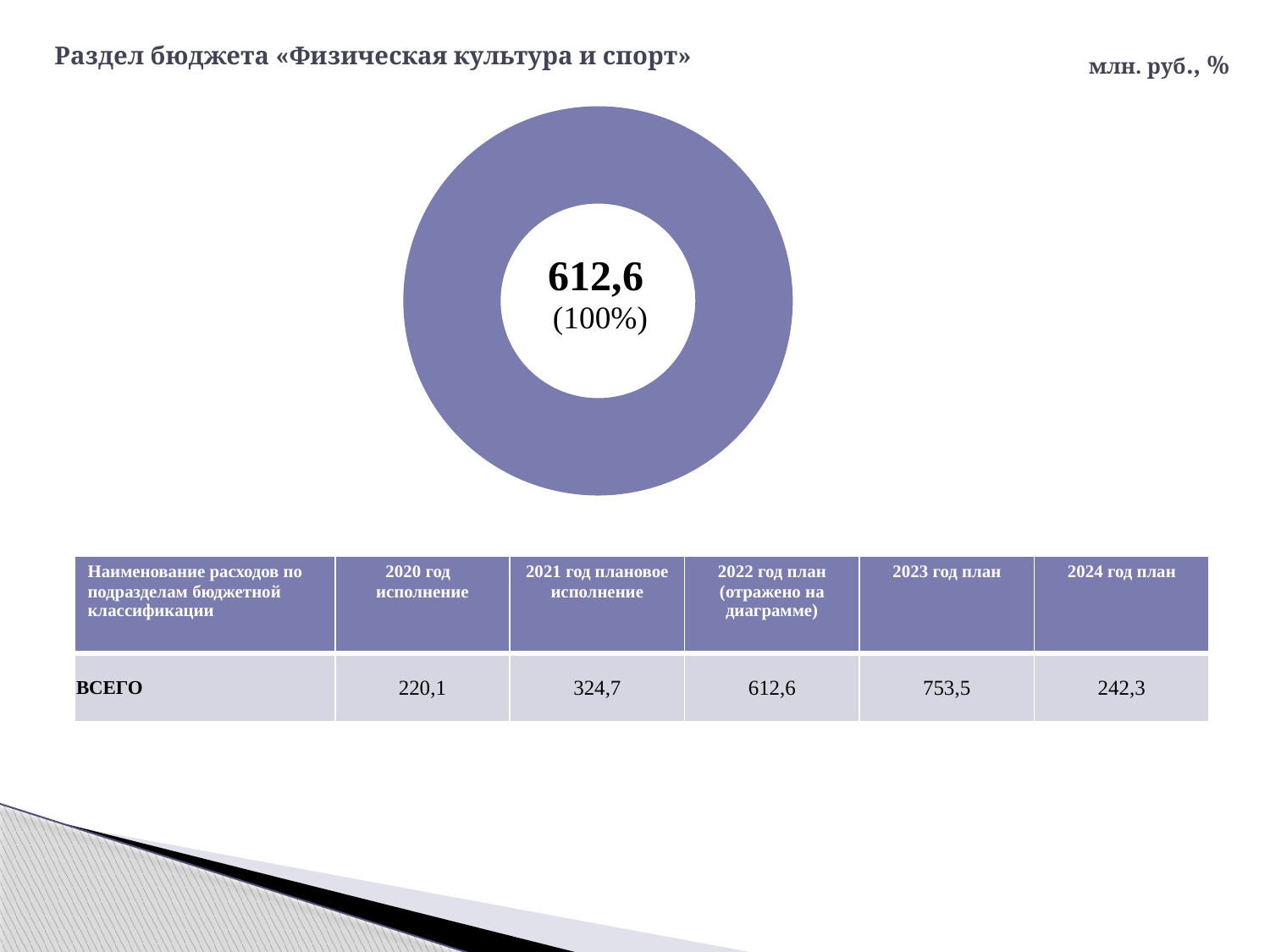
What share of the donut chart does the single slice represent? 100% What value is printed in the centre of the donut chart? 612,6 Which year's value from the table is reflected in the donut chart? 2022 год план What kind of chart is shown on the slide? Donut (pie) chart How many slices does the donut chart contain? 1 What is the value for 2022 год план shown in the donut chart? 612,6 What units are indicated for the chart values in the top right of the slide? млн. руб., %